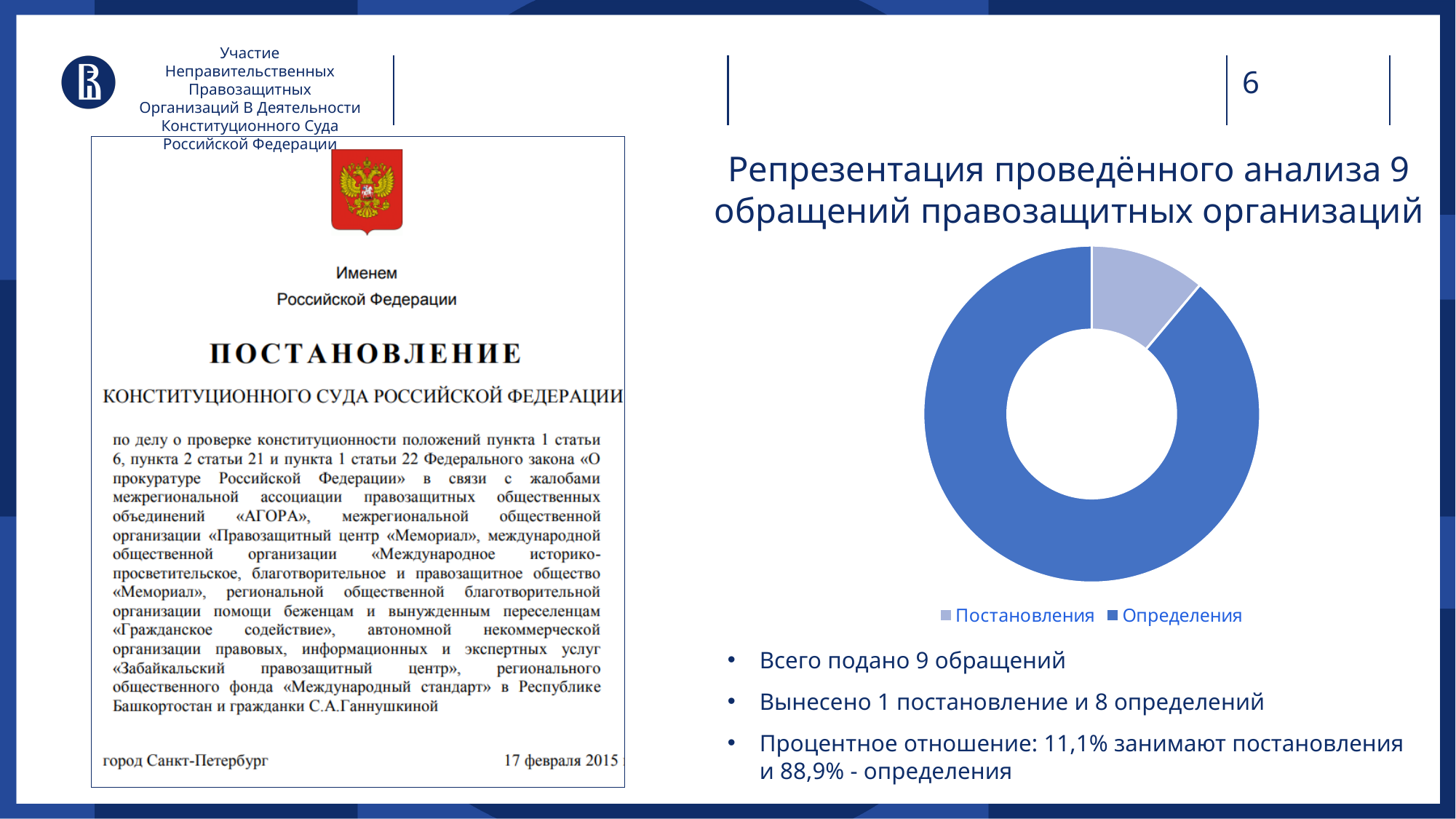
What kind of chart is shown on the slide? Doughnut (pie) chart How many entries does the legend of the doughnut chart list? 2 Which is larger in the doughnut chart, Постановления or Определения? Определения Which category takes the smallest share of the doughnut chart? Постановления How many определений are represented in the doughnut chart, according to the slide? 8 How many categories does the doughnut chart show? 2 How many обращений in total does the doughnut chart represent? 9 What is the title of the chart on the slide? Репрезентация проведённого анализа 9 обращений правозащитных организаций What share of the doughnut chart do Определения occupy, according to the slide? 88,9% Which category takes the largest share of the doughnut chart? Определения What share of the doughnut chart do Постановления occupy, according to the slide? 11,1% Which legend entry is shown in the lighter blue colour? Постановления